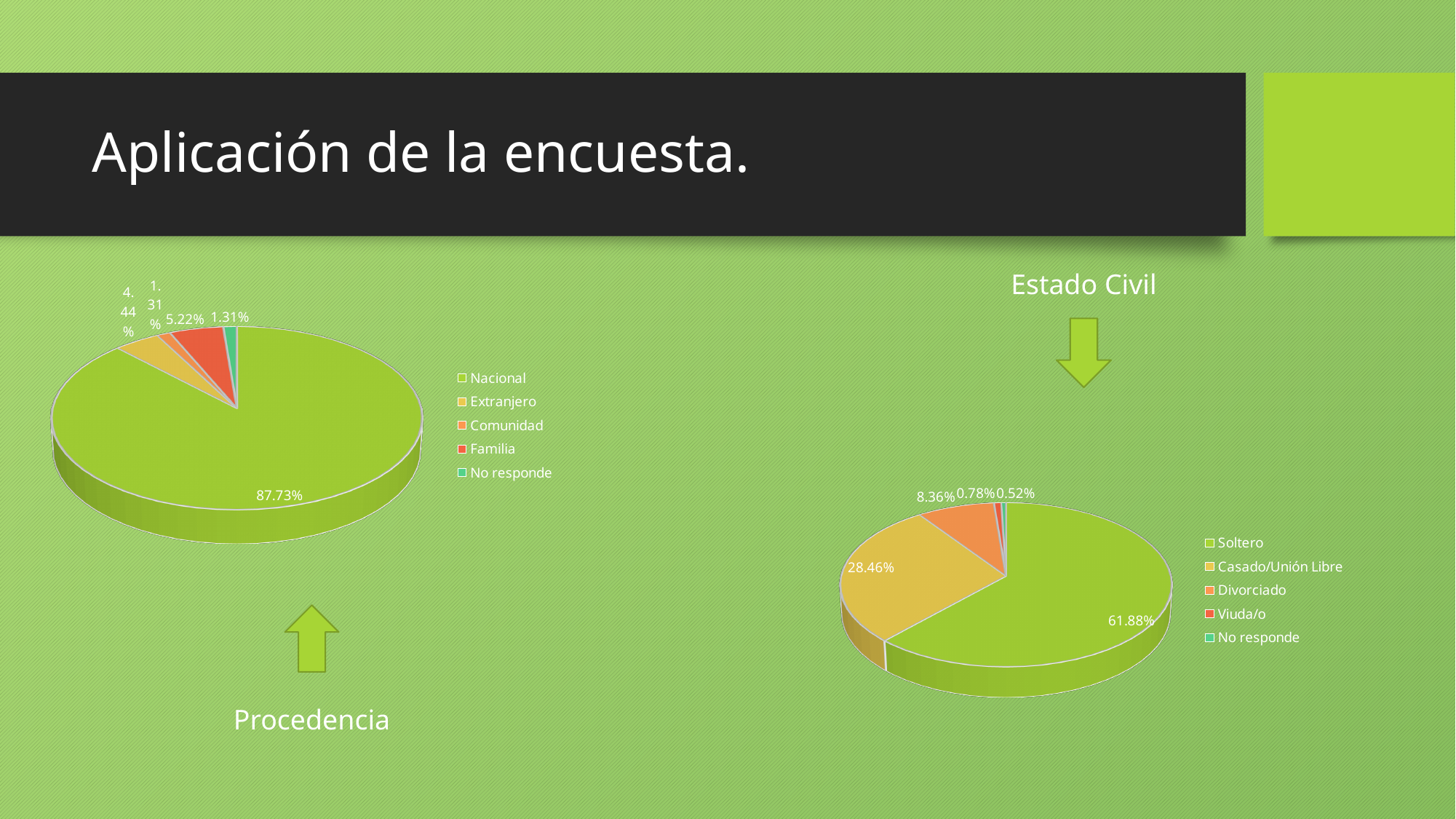
In the Procedencia chart, what percentage is Familia? 5.22% In the Procedencia chart, what percentage is Nacional? 87.73% In the Procedencia chart, which is larger, Familia or Extranjero? Familia In the Estado Civil chart, what percentage is Divorciado? 8.36% In the Estado Civil chart, what percentage is Soltero? 61.88% How many categories does the legend of the Estado Civil chart list? 5 What type of chart is the Procedencia chart? Pie chart In the Estado Civil chart, what percentage is Casado/Unión Libre? 28.46% In the Estado Civil chart, what is the difference between Soltero and Casado/Unión Libre? 33.42% In the Procedencia chart, what percentage is Extranjero? 4.44% In the Estado Civil chart, which category has the largest share? Soltero In the Estado Civil chart, which category has the smallest share? No responde